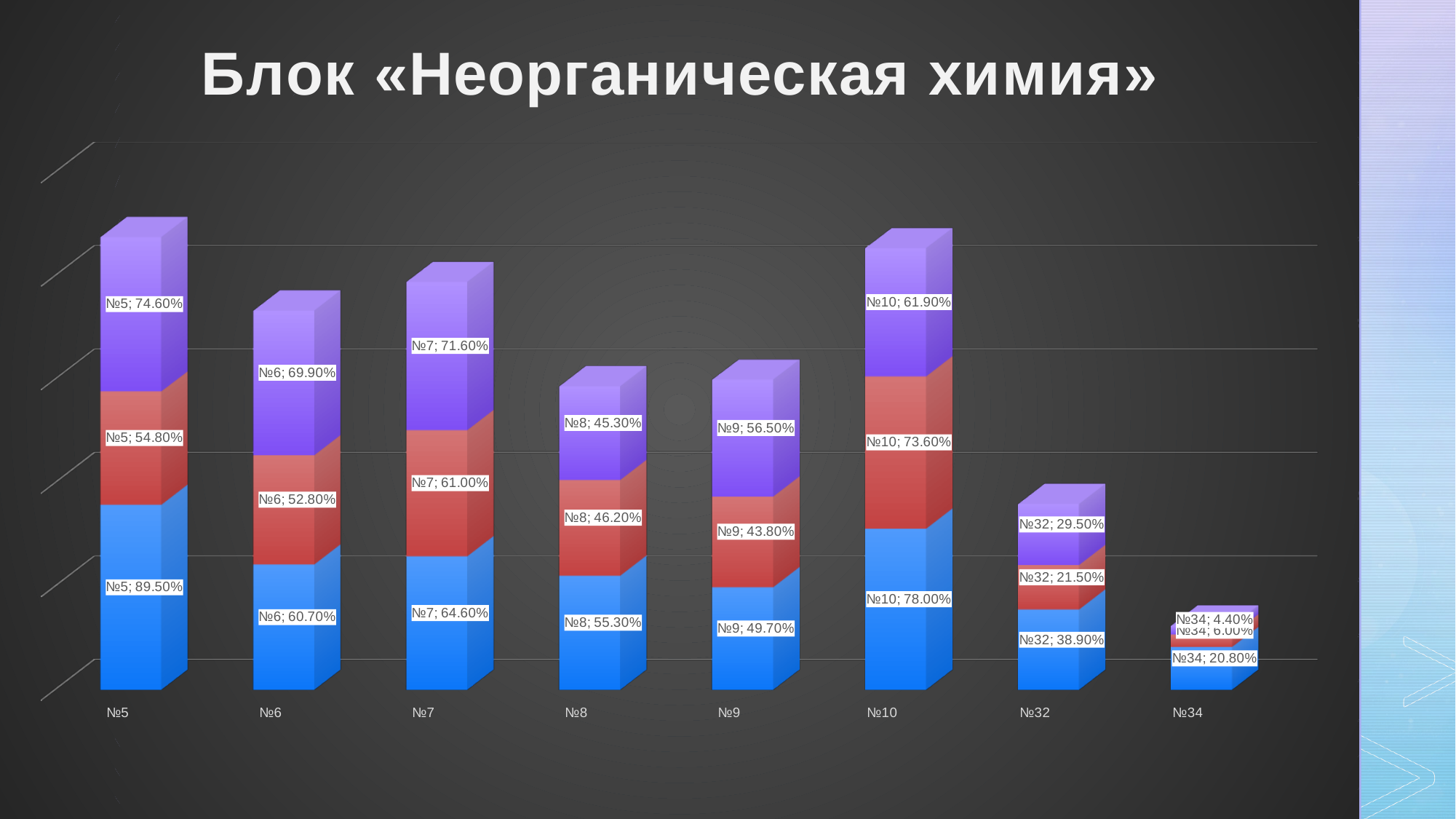
What is the value of the bottom (blue) segment for category №32? 38.90% What type of chart is shown on the slide? Stacked bar chart Which category has the highest value in the bottom (blue) segment? №5 How many categories are shown on the x axis? 8 What is the value of the top (purple) segment for category №10? 61.90% How many segments (series) are stacked in each bar? 3 What is the difference between the bottom (blue) segment values of №5 and №6? 28.80% What is the value of the middle (red) segment for category №7? 61.00% Which is larger: the middle (red) segment of №10 or the middle (red) segment of №9? №10 Which category has the lowest value in the top (purple) segment? №34 What is the total of the stacked bar for category №5? 218.90% What is the value of the bottom (blue) segment for category №5? 89.50%